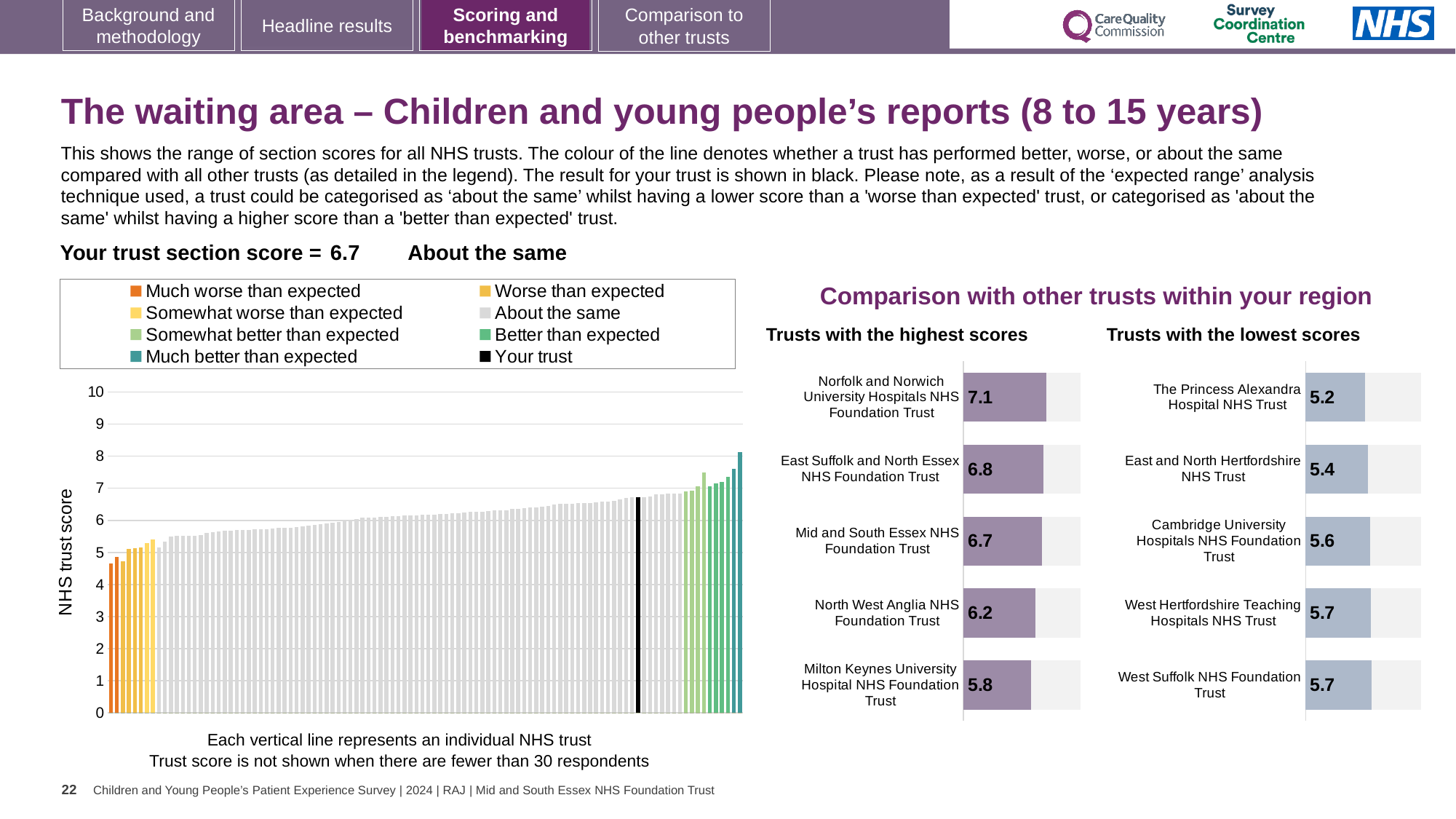
In the 'Trusts with the highest scores' chart, what is the score for Norfolk and Norwich University Hospitals NHS Foundation Trust? 7.1 In the 'Trusts with the highest scores' chart, which trust has the highest score? Norfolk and Norwich University Hospitals NHS Foundation Trust In the main 'NHS trust score' chart, what does the black bar represent? Your trust In the 'Trusts with the lowest scores' chart, what is the difference between the scores of West Suffolk NHS Foundation Trust and The Princess Alexandra Hospital NHS Trust? 0.5 How many trusts are listed in the 'Trusts with the lowest scores' chart? 5 What kind of chart is the main 'NHS trust score' chart on the left? Bar chart In the main 'NHS trust score' chart, do the bar values rise or fall from left to right? Rise In the 'Trusts with the highest scores' chart, which has the higher score: East Suffolk and North Essex NHS Foundation Trust or North West Anglia NHS Foundation Trust? East Suffolk and North Essex NHS Foundation Trust In the 'Trusts with the lowest scores' chart, which trust has the lowest score? The Princess Alexandra Hospital NHS Trust How many entries does the legend of the main NHS trust score chart list? 8 In the 'Trusts with the lowest scores' chart, what is the score for Cambridge University Hospitals NHS Foundation Trust? 5.6 In the 'Trusts with the highest scores' chart, what is the difference between the scores of Norfolk and Norwich University Hospitals NHS Foundation Trust and Milton Keynes University Hospital NHS Foundation Trust? 1.3